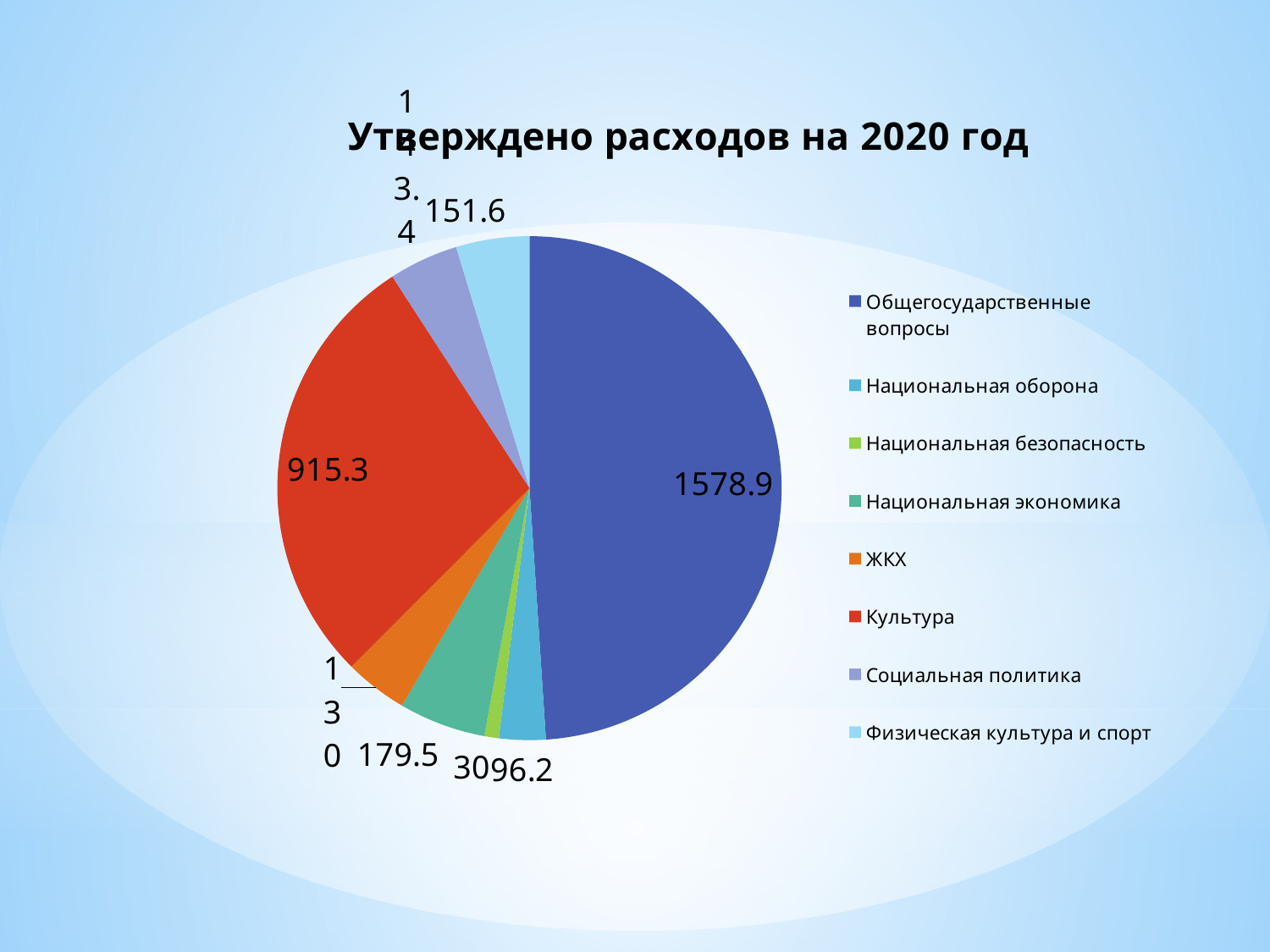
What is the value for Физическая культура и спорт? 151.6 Which colour represents Культура in the legend? red Which category has the smallest slice of the pie? Национальная безопасность What is the value for Культура? 915.3 What is the value for Общегосударственные вопросы? 1578.9 What type of chart is shown on the slide? pie chart Which category has the largest slice of the pie? Общегосударственные вопросы How many categories does the legend list? 8 What is the difference between the values for Общегосударственные вопросы and Культура? 663.6 What is the title of the chart? Утверждено расходов на 2020 год Which is larger, the value for Культура or the value for Общегосударственные вопросы? Общегосударственные вопросы What is the value for Национальная экономика? 179.5